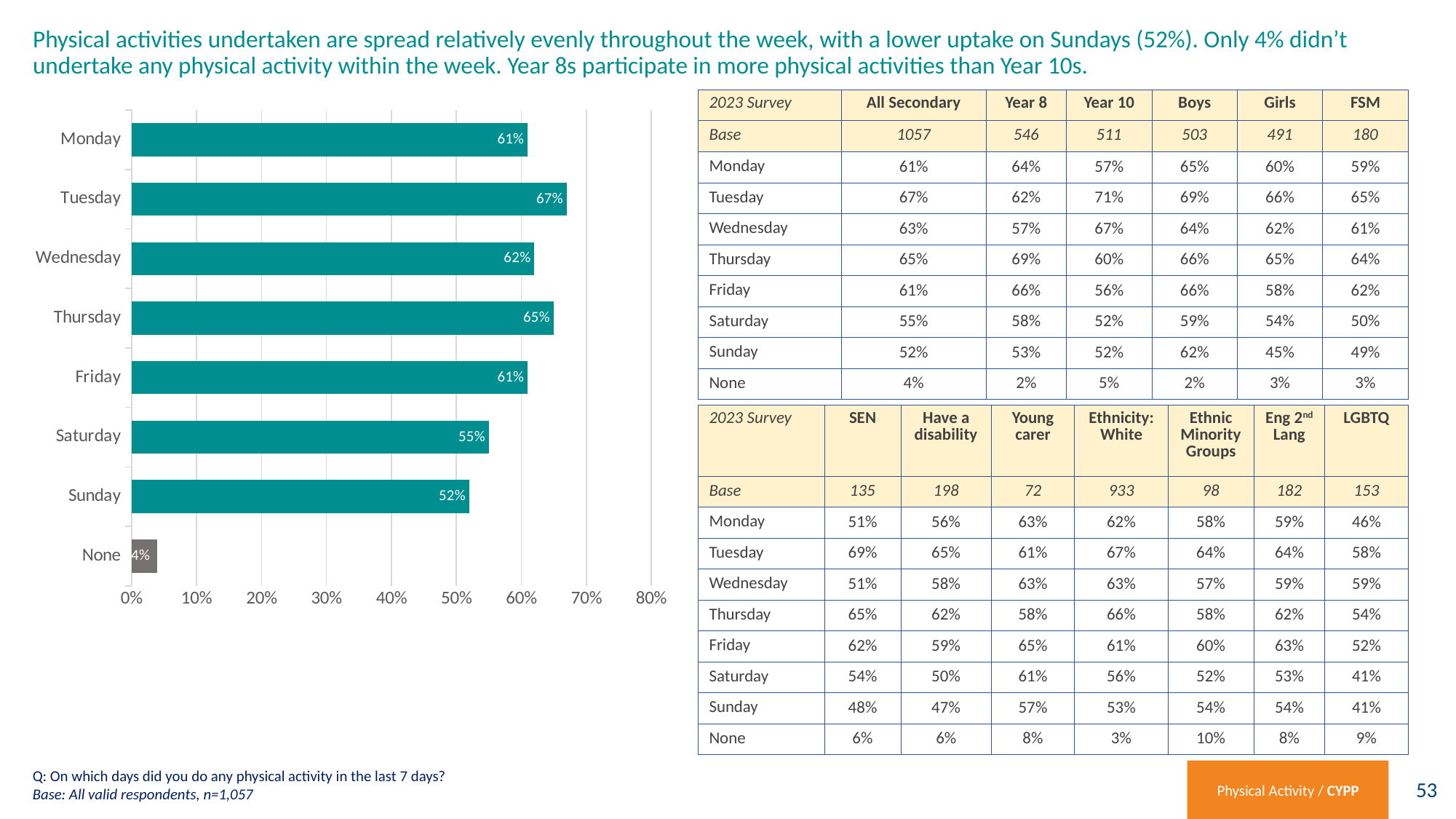
What is the value for Tuesday in the bar chart? 67% What kind of chart is shown on the slide? bar chart What is the highest value shown on the x axis of the bar chart? 80% What is the difference between the values for Thursday and Wednesday in the bar chart? 3% Which day has the highest value in the bar chart? Tuesday What is the difference between the values for Tuesday and Sunday in the bar chart? 15% Which is larger in the bar chart, the value for Thursday or the value for Saturday? Thursday What is the value for None in the bar chart? 4% Is the value for Saturday in the bar chart greater or less than 60%? less What is the value for Sunday in the bar chart? 52% How many categories are shown in the bar chart? 8 Which category has the lowest value in the bar chart? None